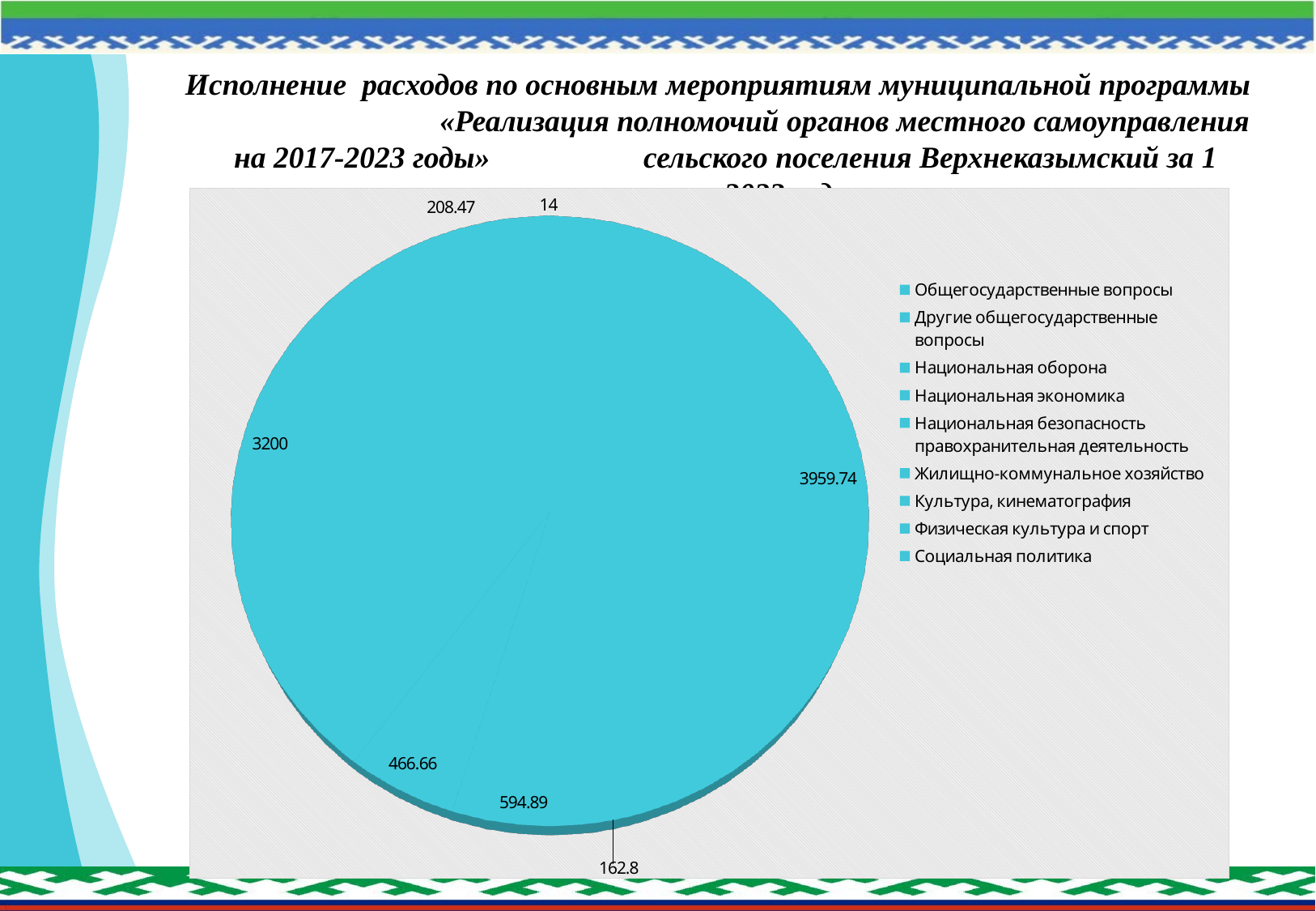
What is the difference between the data labels 594.89 and 466.66 on the pie chart? 128.23 Which of the data labels 594.89 and 466.66 on the pie chart is larger? 594.89 How many data labels are printed on the pie chart? 7 What is the largest value printed as a data label on the pie chart? 3959.74 How many entries does the legend of the pie chart list? 9 What is the smallest value printed as a data label on the pie chart? 14 What is the first entry listed in the legend of the pie chart? Общегосударственные вопросы Which of the data labels 208.47 and 162.8 on the pie chart is larger? 208.47 What is the last entry listed in the legend of the pie chart? Социальная политика What is the difference between the two largest data labels on the pie chart, 3959.74 and 3200? 759.74 What kind of chart is shown on the slide? pie chart